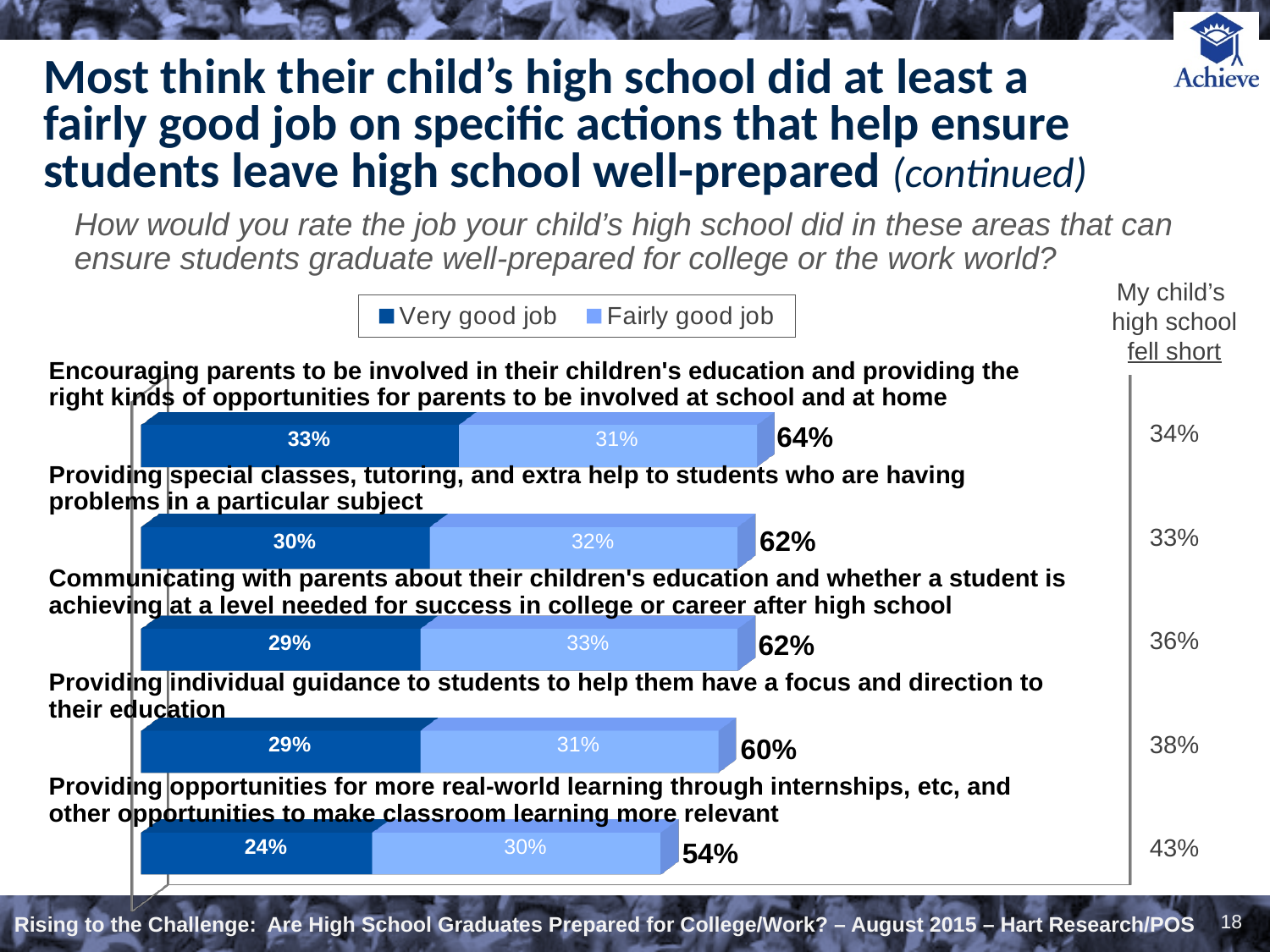
What type of chart is shown on the slide? Stacked bar chart What percentage said their child's high school fell short on providing individual guidance to students to help them have a focus and direction to their education? 38% Which item has the lowest combined very good/fairly good rating? Providing opportunities for more real-world learning through internships How many series does the chart legend list? 2 Which item has the highest combined very good/fairly good rating? Encouraging parents to be involved in their children's education What are the two series named in the chart legend? Very good job and Fairly good job What is the difference between the combined rating for encouraging parents to be involved (64%) and for providing real-world learning opportunities (54%)? 10 percentage points What percentage rated the school as doing a fairly good job providing special classes, tutoring, and extra help to students having problems in a particular subject? 32% What percentage of parents said their child's high school did a very good job encouraging parents to be involved in their children's education? 33% What is the combined very good/fairly good total for providing opportunities for more real-world learning through internships? 54% How many items (categories) are rated in the chart? 5 Which is larger: the very good job share for providing special classes and tutoring, or the very good job share for providing real-world learning opportunities? Providing special classes and tutoring